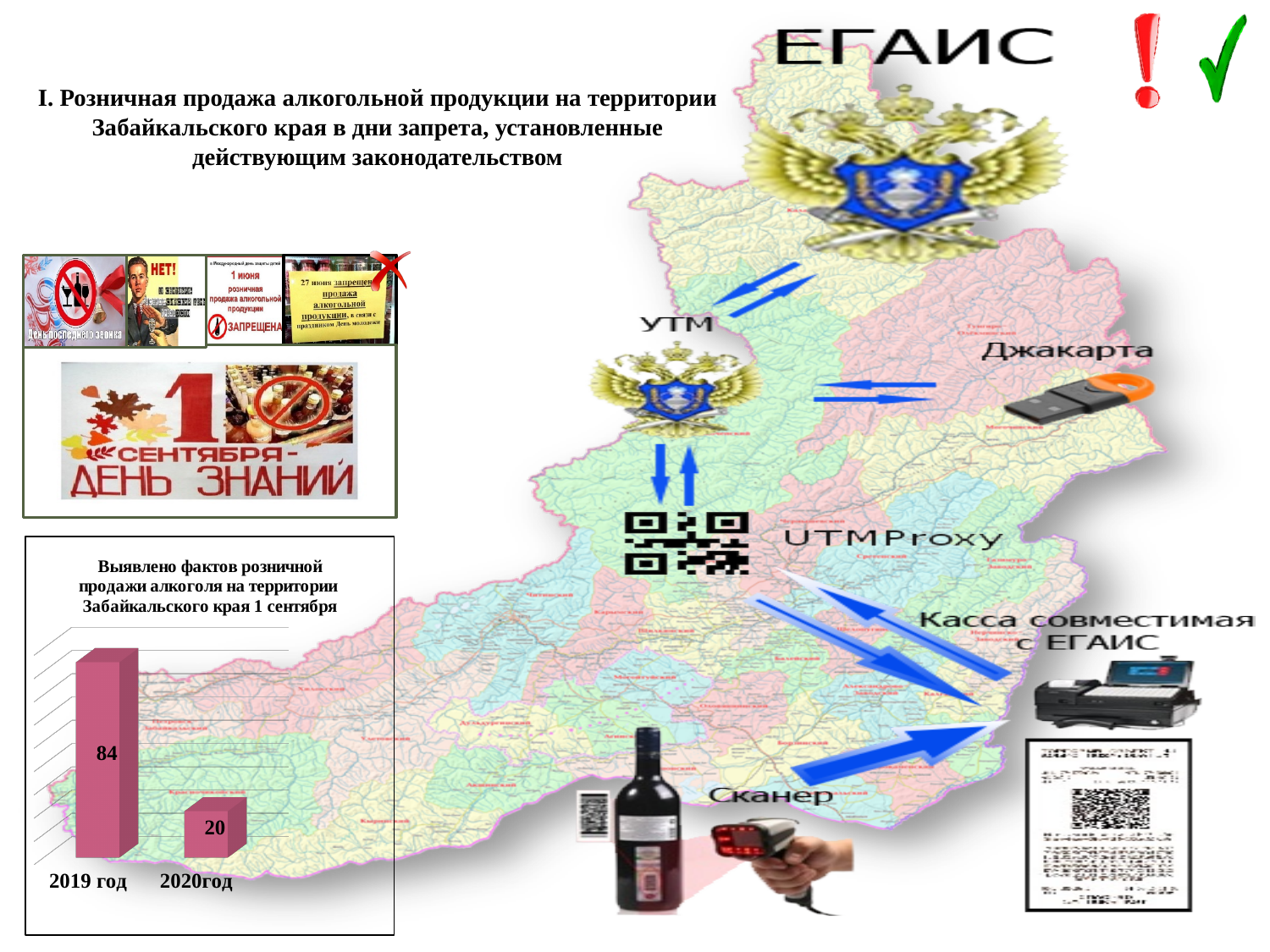
What value is shown for 2019 год in the chart? 84 What value is shown for 2020год in the chart? 20 By how much does the 2019 value exceed the 2020 value in the chart? 64 What type of chart is shown on the slide? bar chart How many bars does the chart contain? 2 Which year has the lower bar in the chart? 2020год Which year has the higher bar in the chart? 2019 год What is the title of the chart? Выявлено фактов розничной продажи алкоголя на территории Забайкальского края 1 сентября What is the total of the two bars in the chart? 104 Do the values in the chart rise or fall from 2019 to 2020? fall Is the value for 2019 год larger or smaller than the value for 2020год? larger What colour are the bars in the chart? pink/magenta